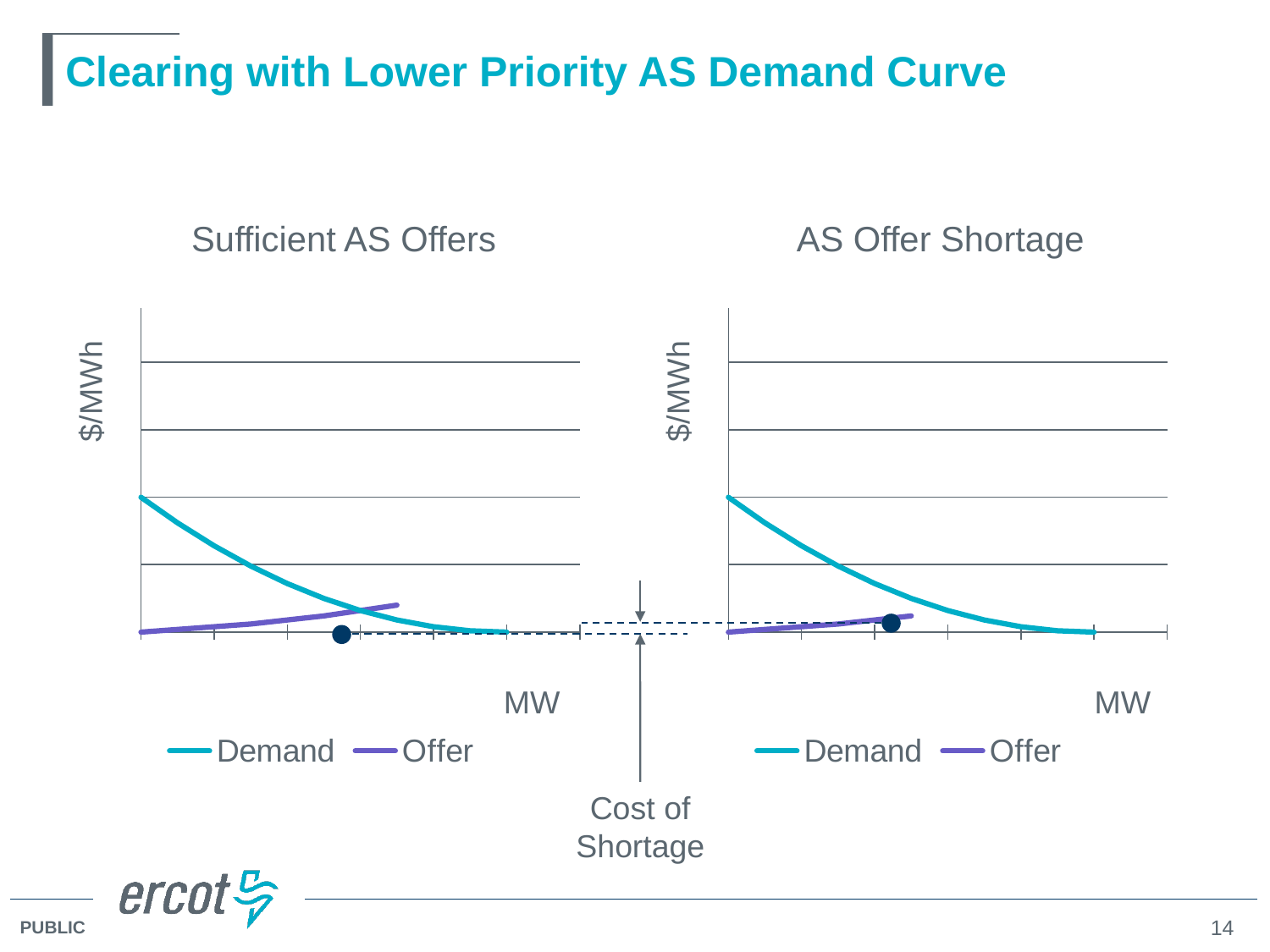
How many series does the legend of the "AS Offer Shortage" chart list? 2 What kind of chart is the "Sufficient AS Offers" chart? line chart What are the two series named in the legend of the "AS Offer Shortage" chart? Demand and Offer In the "AS Offer Shortage" chart, does the Demand curve rise or fall as MW increases? fall In the "Sufficient AS Offers" chart, does the Offer curve rise or fall as MW increases? rise How many series does the legend of the "Sufficient AS Offers" chart list? 2 In the "Sufficient AS Offers" chart, does the Demand curve rise or fall as MW increases? fall What is the y-axis label on the "Sufficient AS Offers" chart? $/MWh How many charts are shown on the slide? 2 What kind of chart is the "AS Offer Shortage" chart? line chart